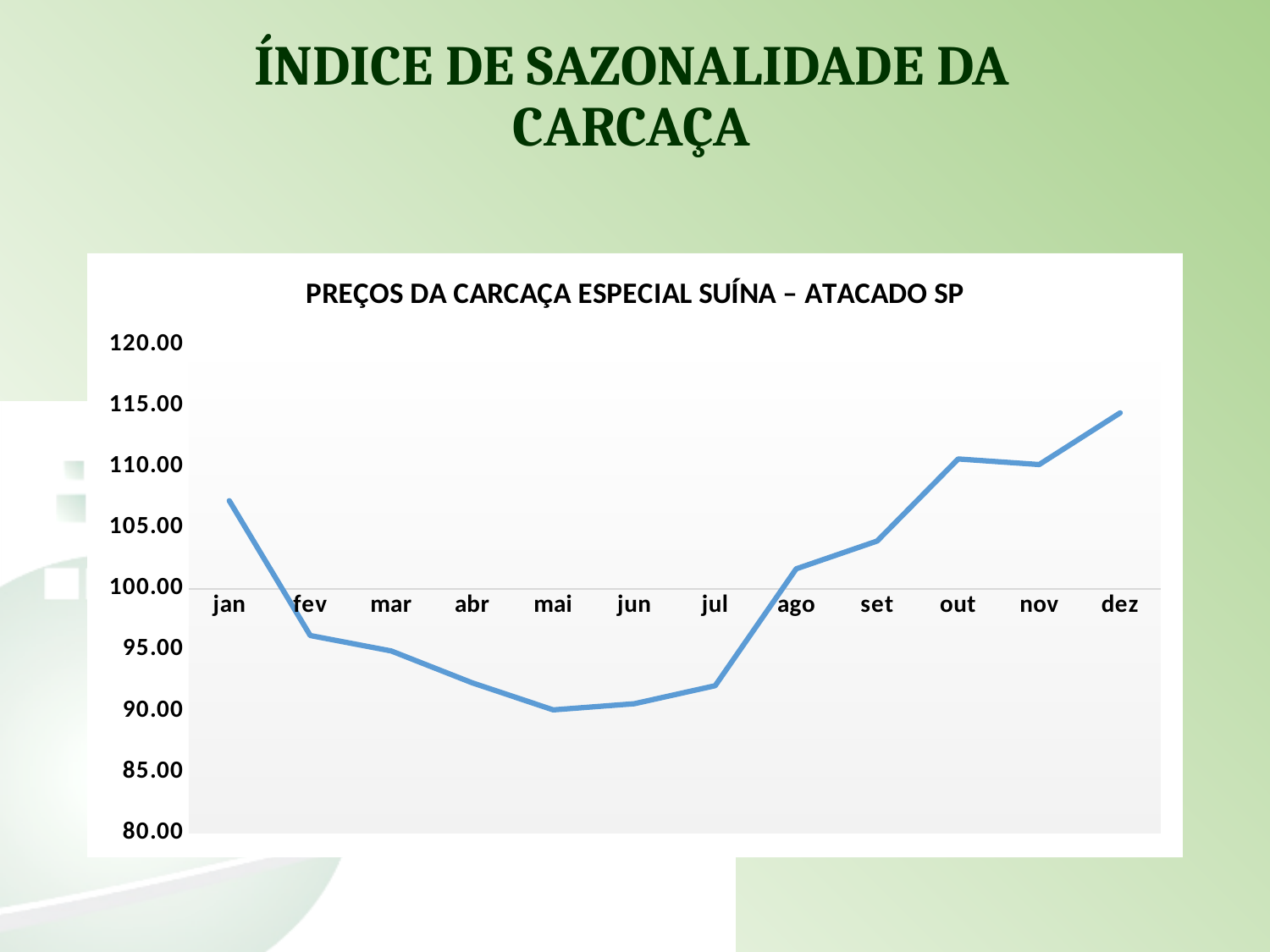
Is the value for mai greater or less than 95? less Is the value for fev greater or less than 100? less What kind of chart is shown on the slide? line chart Which is larger, the value for jan or the value for fev? jan Which month has the highest value? dez What is the title of the chart? PREÇOS DA CARCAÇA ESPECIAL SUÍNA – ATACADO SP Do the values rise or fall from jan to mai? fall Is the value for out greater or less than 105? greater Which is larger, the value for set or the value for jul? set How many months are plotted along the x axis? 12